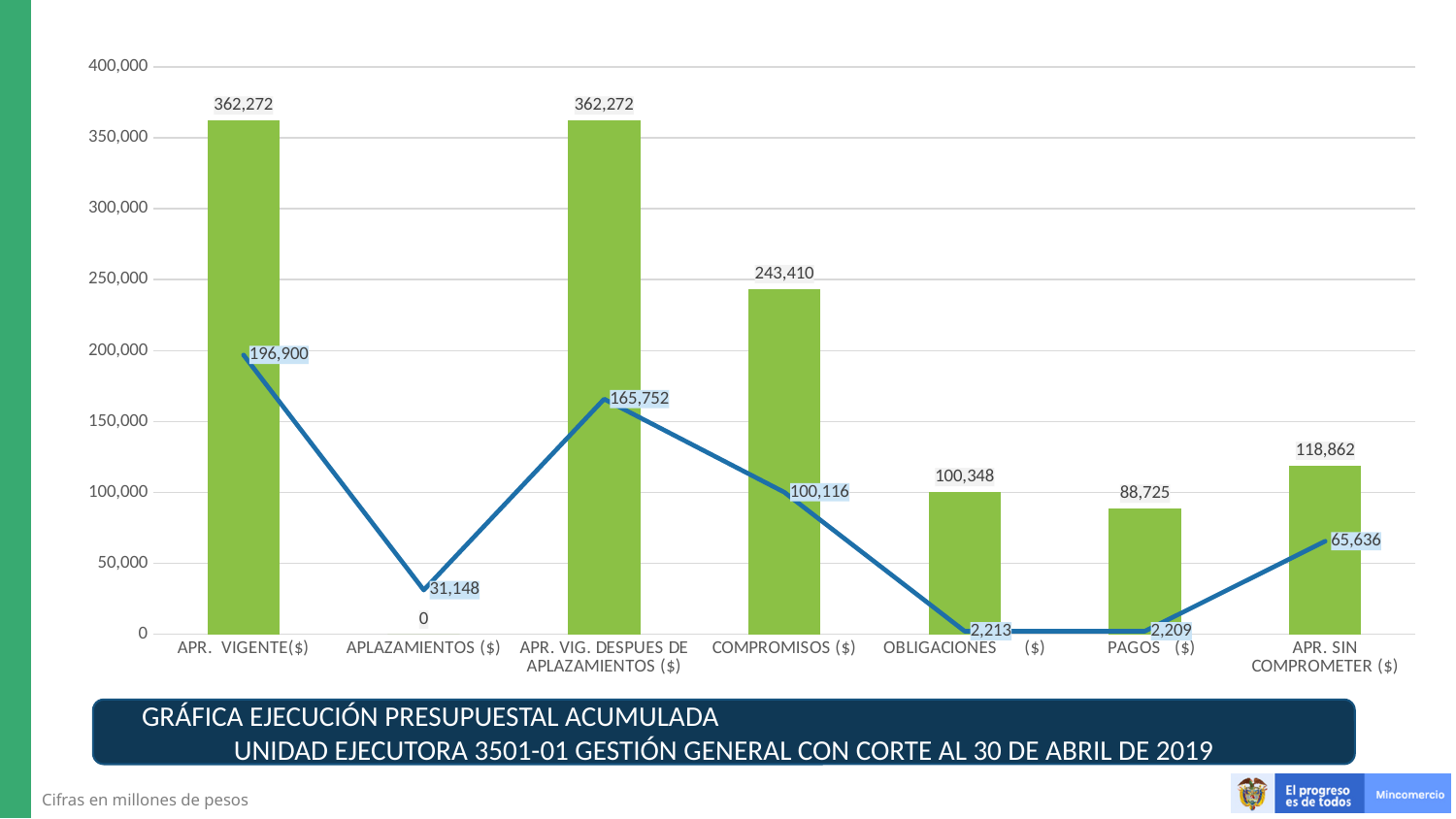
What is the value of the green bar for COMPROMISOS ($)? 243,410 What is the value of the green bar for PAGOS ($)? 88,725 How many categories are shown on the x axis? 7 For APR. VIGENTE($), how much larger is the green bar value than the blue line value? 165,372 Which category has the lowest green bar value? APLAZAMIENTOS ($) What value does the blue line show for APR. SIN COMPROMETER ($)? 65,636 According to the note at the bottom of the slide, in what units are the figures expressed? Millones de pesos Do the blue line values rise or fall from COMPROMISOS ($) to PAGOS ($)? fall What value does the blue line show for APLAZAMIENTOS ($)? 31,148 Which has the larger green bar value, PAGOS ($) or APR. SIN COMPROMETER ($)? APR. SIN COMPROMETER ($) What is the difference between the green bar values for COMPROMISOS ($) and OBLIGACIONES ($)? 143,062 At which category does the blue line reach its highest value? APR. VIGENTE($)